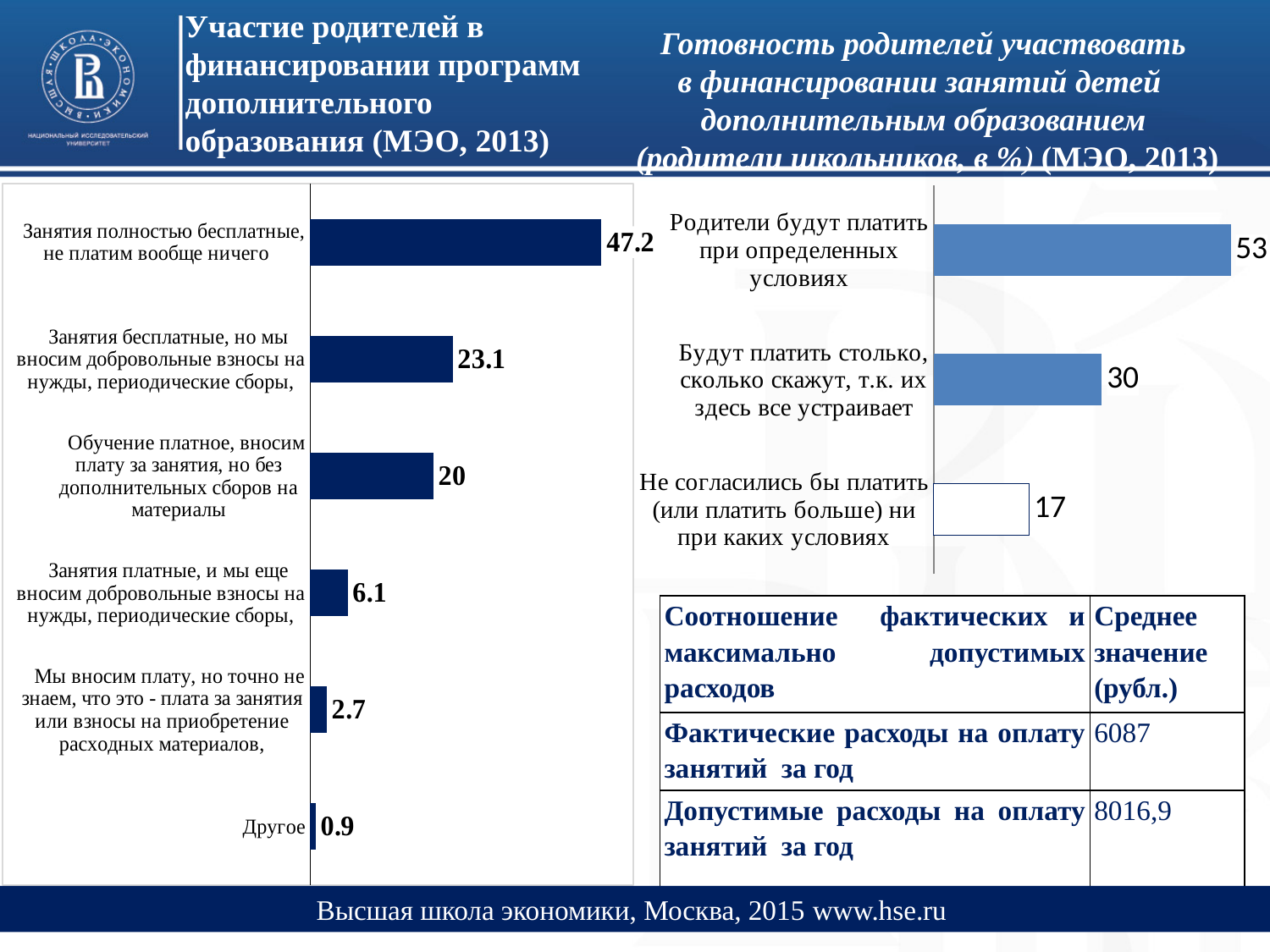
In the left chart (Участие родителей в финансировании программ дополнительного образования), what is the difference between the values for 'Занятия бесплатные, но мы вносим добровольные взносы...' (23.1) and 'Обучение платное, вносим плату за занятия, но без дополнительных сборов на материалы' (20)? 3.1 In the left chart (Участие родителей в финансировании программ дополнительного образования), which category has the highest value? Занятия полностью бесплатные, не платим вообще ничего In the left chart (Участие родителей в финансировании программ дополнительного образования), how many categories are shown? 6 In the right chart (Готовность родителей участвовать в финансировании занятий детей дополнительным образованием), what is the difference between 'Родители будут платить при определенных условиях' and 'Будут платить столько, сколько скажут, т.к. их здесь все устраивает'? 23 In the left chart (Участие родителей в финансировании программ дополнительного образования), what is the value for 'Другое'? 0.9 In the right chart (Готовность родителей участвовать в финансировании занятий детей дополнительным образованием), which category has the lowest value? Не согласились бы платить (или платить больше) ни при каких условиях In the right chart (Готовность родителей участвовать в финансировании занятий детей дополнительным образованием), what is the value for 'Родители будут платить при определенных условиях'? 53 In the left chart (Участие родителей в финансировании программ дополнительного образования), which category has the lowest value? Другое In the right chart (Готовность родителей участвовать в финансировании занятий детей дополнительным образованием), what is the value for 'Не согласились бы платить (или платить больше) ни при каких условиях'? 17 In the right chart (Готовность родителей участвовать в финансировании занятий детей дополнительным образованием), how many categories are shown? 3 In the left chart (Участие родителей в финансировании программ дополнительного образования), what is the value for 'Занятия полностью бесплатные, не платим вообще ничего'? 47.2 What type of chart is the left chart (Участие родителей в финансировании программ дополнительного образования)? Bar chart